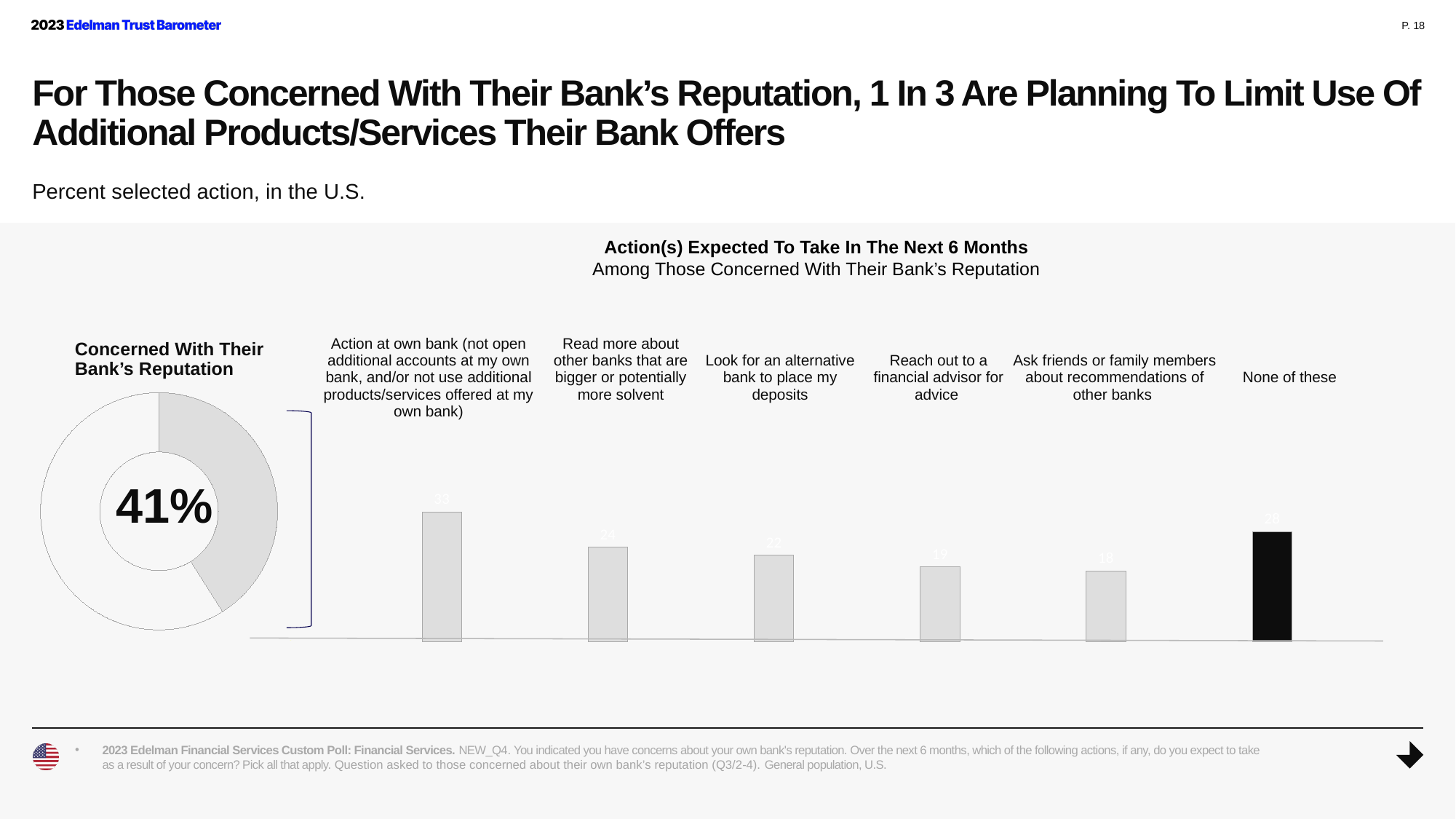
In the "Action(s) Expected To Take In The Next 6 Months" chart, what is the difference between "Action at own bank" (33) and "Reach out to a financial advisor for advice" (19)? 14 What percentage is shown in the centre of the donut chart titled "Concerned With Their Bank's Reputation"? 41% What type of chart is the "Action(s) Expected To Take In The Next 6 Months" chart? Bar chart In the "Action(s) Expected To Take In The Next 6 Months" chart, which action has the highest value? Action at own bank (not open additional accounts at my own bank, and/or not use additional products/services offered at my own bank) In the "Action(s) Expected To Take In The Next 6 Months" chart, what is the value for "Action at own bank"? 33 What type of chart is the chart on the left of the slide? Donut (pie) chart In the "Action(s) Expected To Take In The Next 6 Months" chart, which action has the lowest value? Ask friends or family members about recommendations of other banks In the "Action(s) Expected To Take In The Next 6 Months" chart, what is the value for "None of these"? 28 In the "Action(s) Expected To Take In The Next 6 Months" chart, how many action categories are plotted? 6 In the "Action(s) Expected To Take In The Next 6 Months" chart, what is the value for "Look for an alternative bank to place my deposits"? 22 In the "Action(s) Expected To Take In The Next 6 Months" chart, which bar is coloured black rather than grey? None of these In the "Action(s) Expected To Take In The Next 6 Months" chart, which is larger: "None of these" or "Read more about other banks that are bigger or potentially more solvent"? None of these